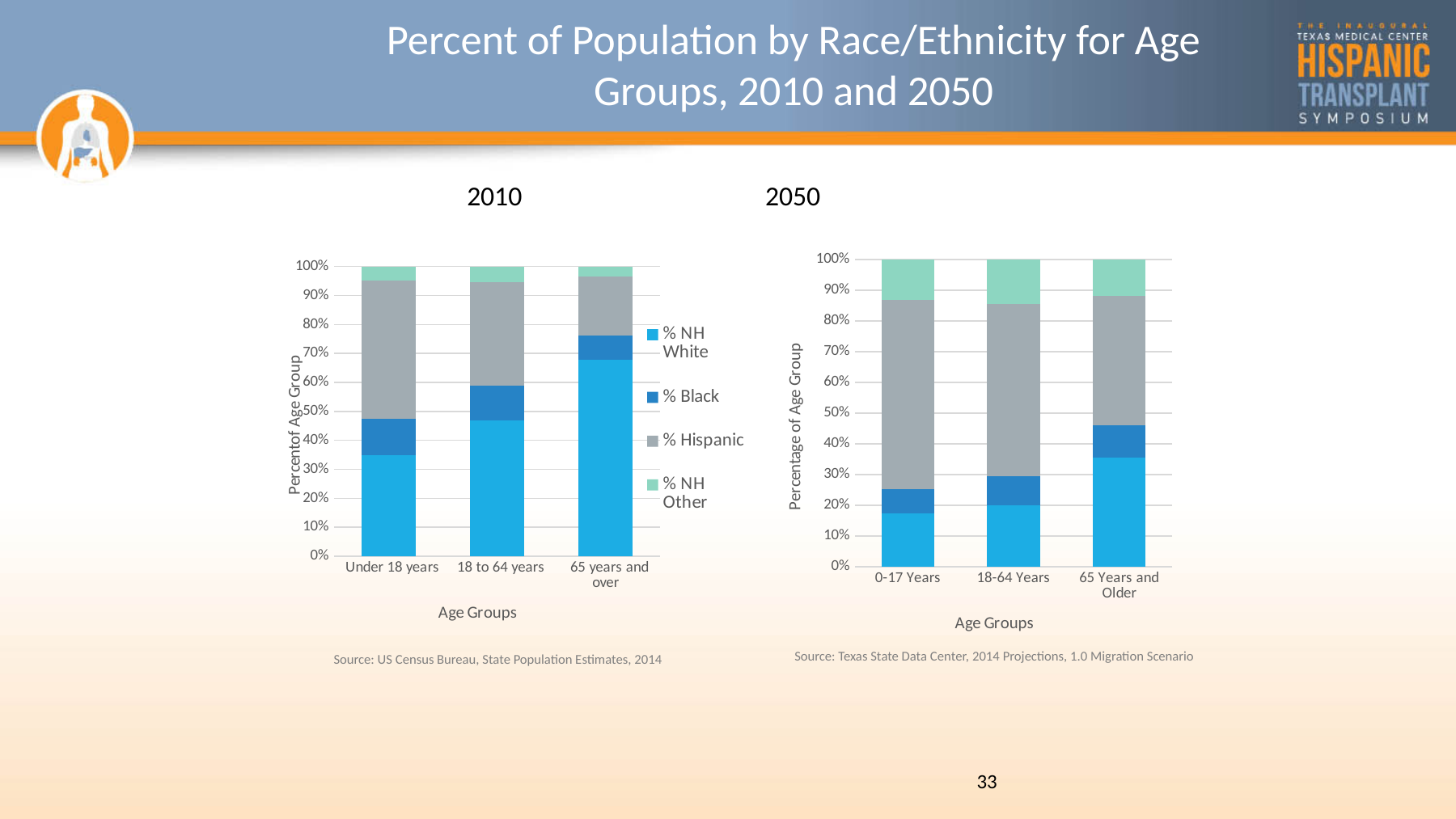
In the 2010 chart, how many age groups are shown on the x axis? 3 In the 2050 chart, how many age groups are shown on the x axis? 3 In the 2010 chart, which age group has the smallest % NH White segment? Under 18 years In the 2050 chart, is the bottom light-blue segment for 65 Years and Older greater or less than 30%? greater In the 2050 chart, is the bottom light-blue segment for 0-17 Years greater or less than 25%? less How many series does the legend of the 2010 chart list? 4 What is the y-axis title of the 2010 chart? Percent of Age Group In the 2010 chart, is the % NH White value for 65 years and over greater or less than 60%? greater In the 2010 chart, which age group has the largest % NH White segment? 65 years and over What kind of chart is the 2010 chart on the left? stacked bar chart In the 2010 chart, is the % Hispanic segment larger for Under 18 years or for 65 years and over? Under 18 years